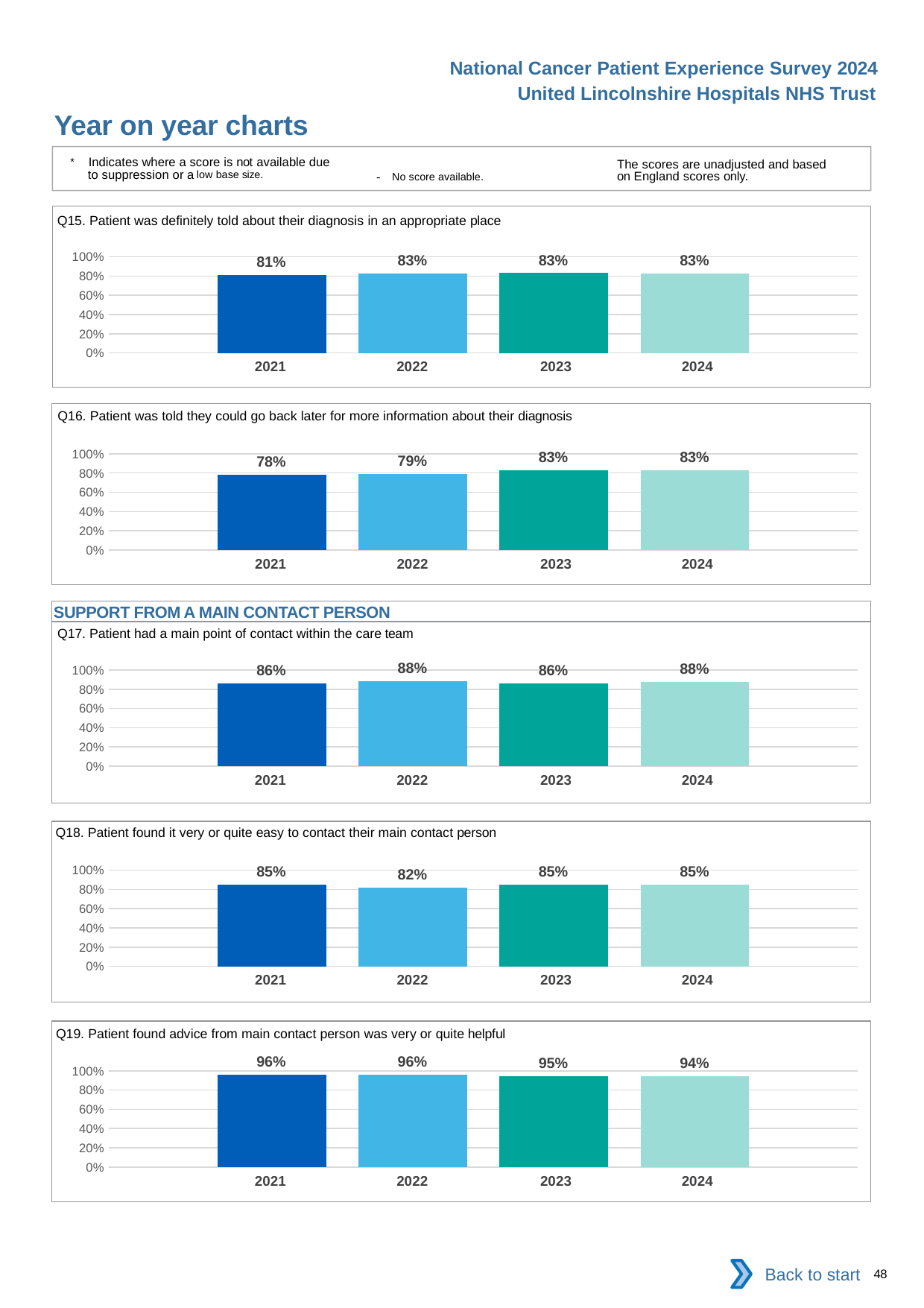
In the Q18 chart, which year has the lowest value? 2022 In the Q19 chart, do the values rise or fall from 2022 to 2024? fall In the Q18 chart, is the value for 2021 larger or smaller than the value for 2022? larger In the Q16 chart, what is the value for 2022? 79% How many years are shown in the Q15 chart? 4 In the Q17 chart, what is the value for 2022? 88% In the Q19 chart, what is the difference between the 2021 and 2023 values? 1 percentage point In the Q19 chart, what is the value for 2024? 94% In the Q16 chart, which year has the lowest value? 2021 What kind of chart is the Q17 chart? bar chart In the Q16 chart, what is the difference between the 2023 and 2021 values? 5 percentage points In the Q15 chart, what is the value for 2021? 81%